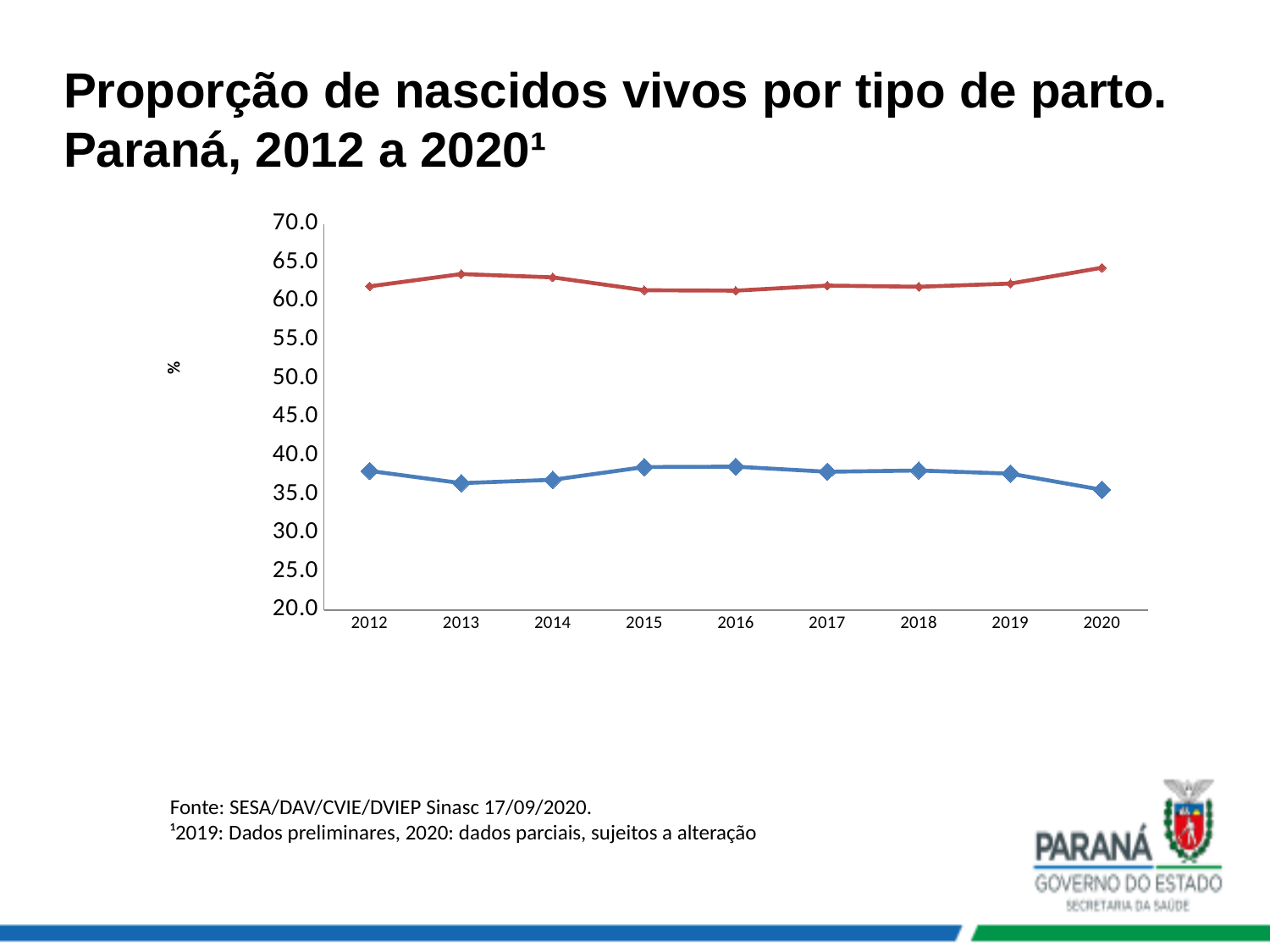
Does the blue line rise or fall from 2019 to 2020? fall Is the value of the red line for 2012 greater or less than 60.0? greater Does the red line rise or fall from 2019 to 2020? rise How many lines are plotted on the chart? 2 How many years are plotted along the x axis? 9 Is the value of the blue line for 2013 greater or less than 40.0? less In which year does the blue line reach its lowest value? 2020 Is the value of the red line for 2015 greater or less than 65.0? less What is the label on the y axis of the chart? % In 2016, which line has the higher value, the red line or the blue line? the red line What kind of chart is shown on the slide? line chart